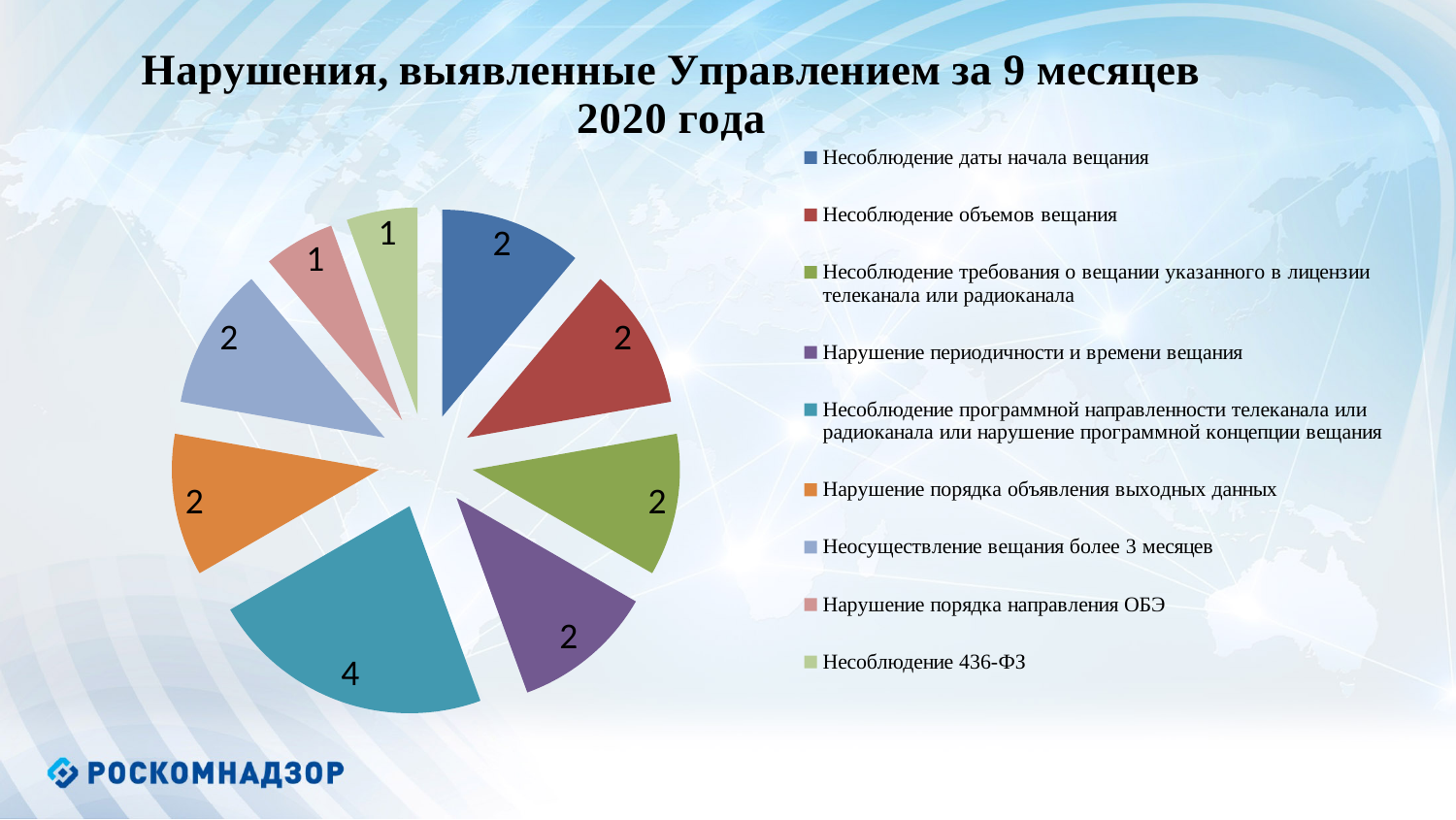
Which is larger: the value for "Неосуществление вещания более 3 месяцев" or the value for "Нарушение порядка направления ОБЭ"? Неосуществление вещания более 3 месяцев What is the difference between the value for "Несоблюдение программной направленности телеканала или радиоканала или нарушение программной концепции вещания" and the value for "Несоблюдение 436-ФЗ"? 3 What is the value for "Несоблюдение программной направленности телеканала или радиоканала или нарушение программной концепции вещания"? 4 How many slices does the pie chart have? 9 What is the title of the chart on the slide? Нарушения, выявленные Управлением за 9 месяцев 2020 года What is the value for "Несоблюдение даты начала вещания"? 2 What is the value for "Нарушение порядка объявления выходных данных"? 2 What type of chart is shown on the slide? pie chart What is the value for "Несоблюдение 436-ФЗ"? 1 Which category has the largest slice of the pie? Несоблюдение программной направленности телеканала или радиоканала или нарушение программной концепции вещания What is the value for "Нарушение порядка направления ОБЭ"? 1 How many entries does the legend list? 9